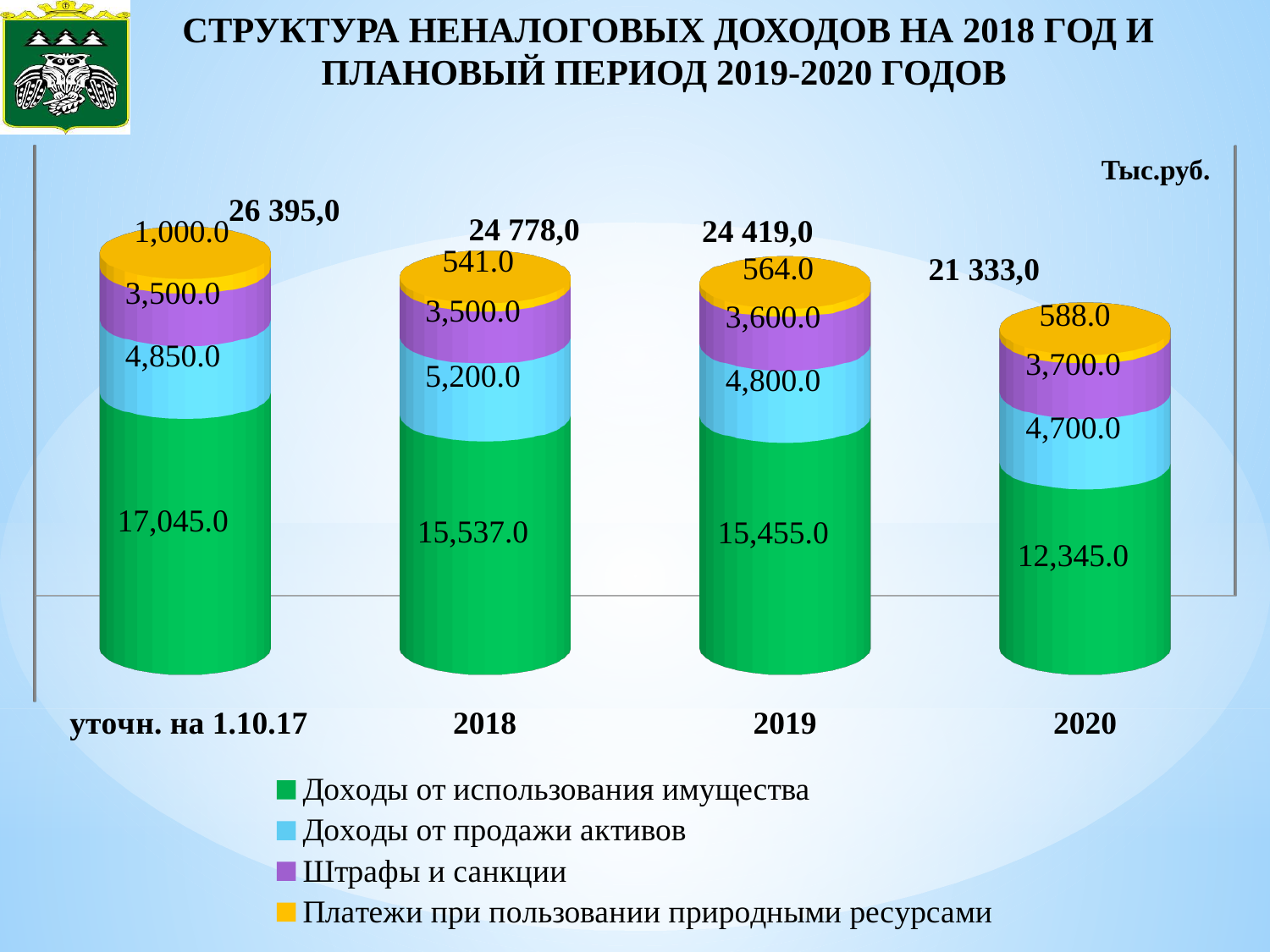
How many categories are shown on the x axis? 4 What is the difference between Доходы от продажи активов in 2018 and in 2020? 500.0 What is the total shown above the bar for 2019? 24 419,0 How many series does the legend list? 4 What is the value of Платежи при пользовании природными ресурсами for уточн. на 1.10.17? 1,000.0 Which is larger: Платежи при пользовании природными ресурсами in 2019 or in 2018? 2019 What kind of chart is shown on the slide? stacked bar chart Which category has the lowest total shown above its bar? 2020 Which category has the highest value for Доходы от использования имущества? уточн. на 1.10.17 What is the value of Доходы от использования имущества for 2018? 15,537.0 What is the value of Доходы от продажи активов for 2019? 4,800.0 What is the value of Штрафы и санкции for 2020? 3,700.0